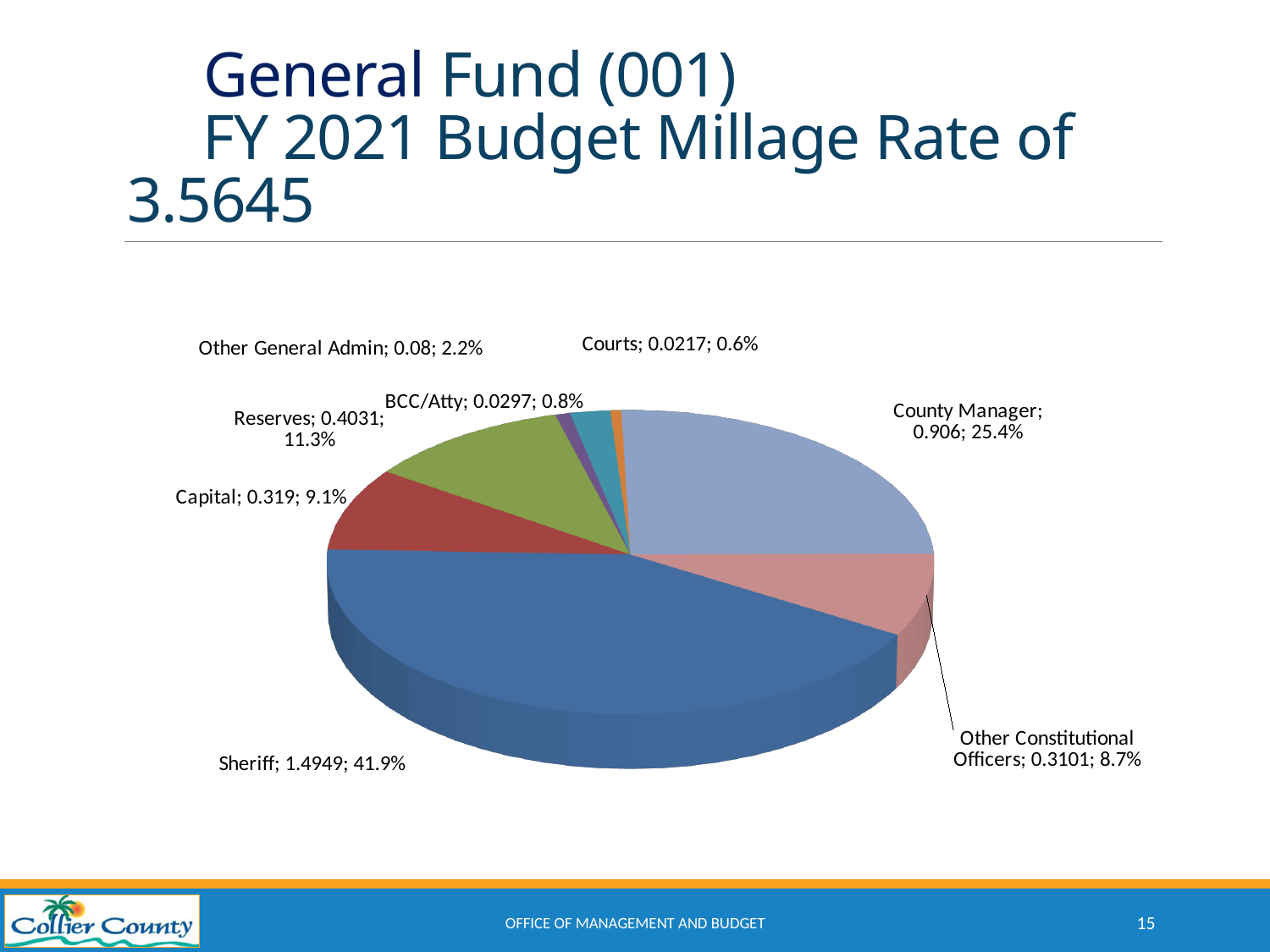
Which category has the smallest slice of the pie? Courts What kind of chart is shown on the slide? Pie chart How many categories are shown in the pie chart? 8 What percentage share does the Capital slice represent? 9.1% Which is larger, the value for Capital or the value for Other Constitutional Officers? Capital What is the millage rate value for BCC/Atty? 0.0297 What is the millage rate value for Reserves? 0.4031 Which category has the largest slice of the pie? Sheriff What percentage share does the County Manager slice represent? 25.4% What is the millage rate value for the Sheriff slice? 1.4949 What is the difference between the percentage shares of Sheriff and County Manager? 16.5% What total millage rate is stated in the slide title? 3.5645